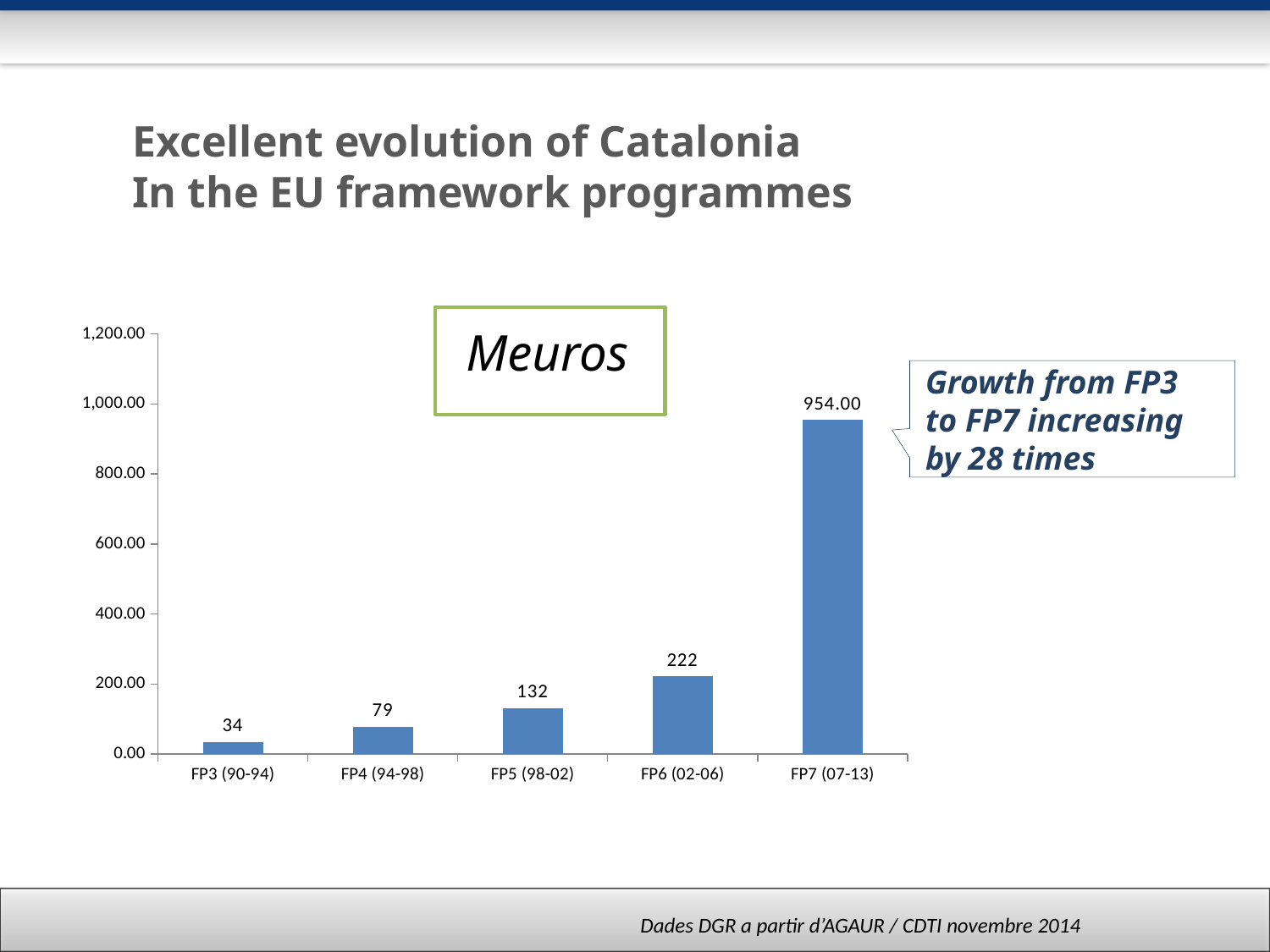
What is the difference between the values for FP6 (02-06) and FP5 (98-02)? 90 Which category has the highest value? FP7 (07-13) Which is larger, the value for FP4 (94-98) or FP6 (02-06)? FP6 (02-06) How many categories are shown on the x axis? 5 Is the value for FP7 (07-13) greater or less than 800.00? greater What unit label is shown in the box above the chart? Meuros What is the value for FP5 (98-02)? 132 Do the values rise or fall from FP3 (90-94) to FP7 (07-13)? rise Which category has the lowest value? FP3 (90-94) What kind of chart is shown on the slide? bar chart What is the value for FP7 (07-13)? 954.00 What is the value for FP3 (90-94)? 34